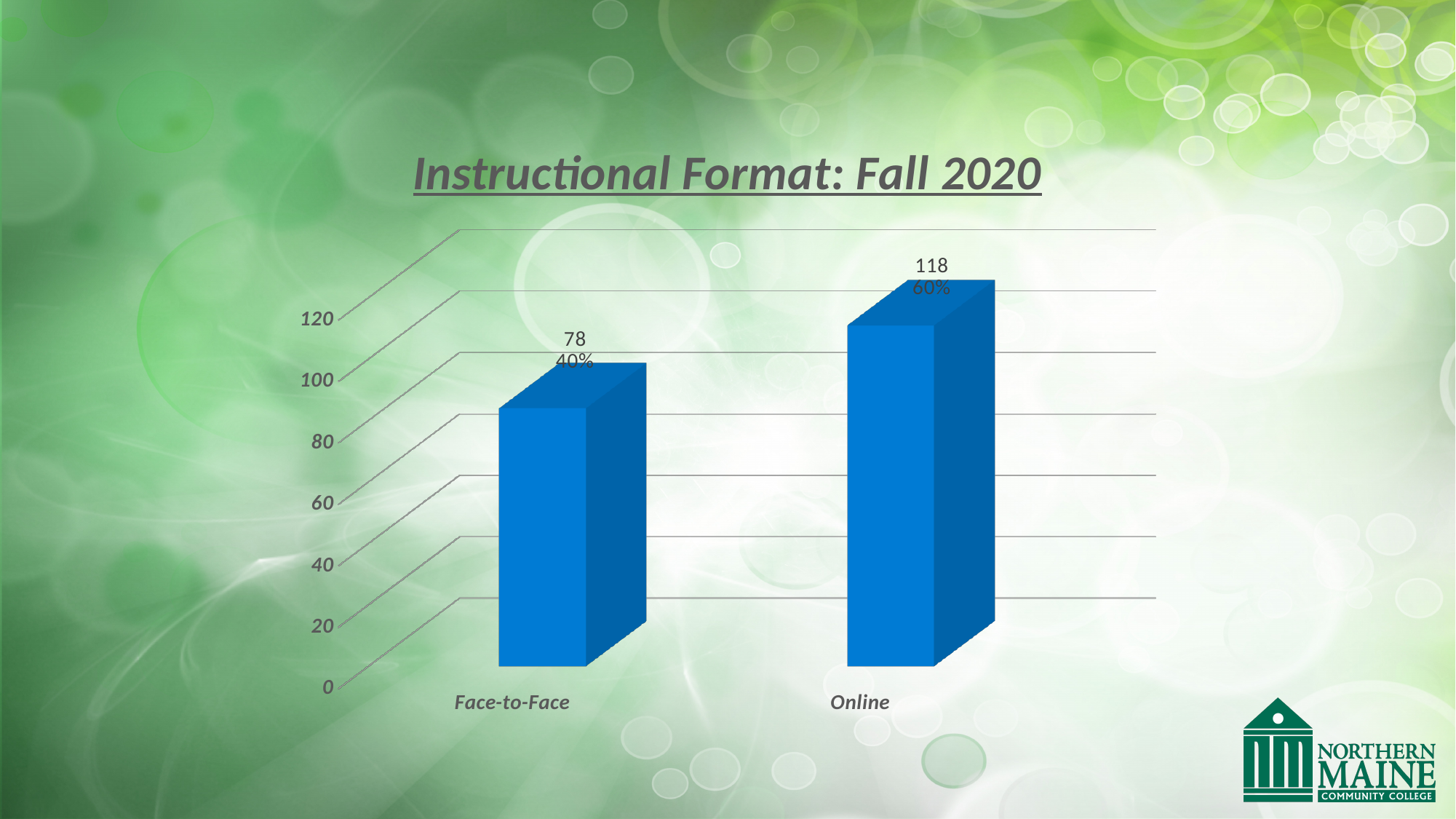
Which instructional format has the lowest value? Face-to-Face What is the value for Face-to-Face? 78 How many categories are shown in the chart? 2 Which instructional format has the highest value? Online Is the value for Online greater or less than 100? greater Which is larger, the value for Face-to-Face or the value for Online? Online What kind of chart is shown on the slide? bar chart What is the difference between the Online and Face-to-Face values? 40 What is the value for Online? 118 What is the title of the chart? Instructional Format: Fall 2020 What percentage is shown for Face-to-Face? 40% What percentage is shown for Online? 60%